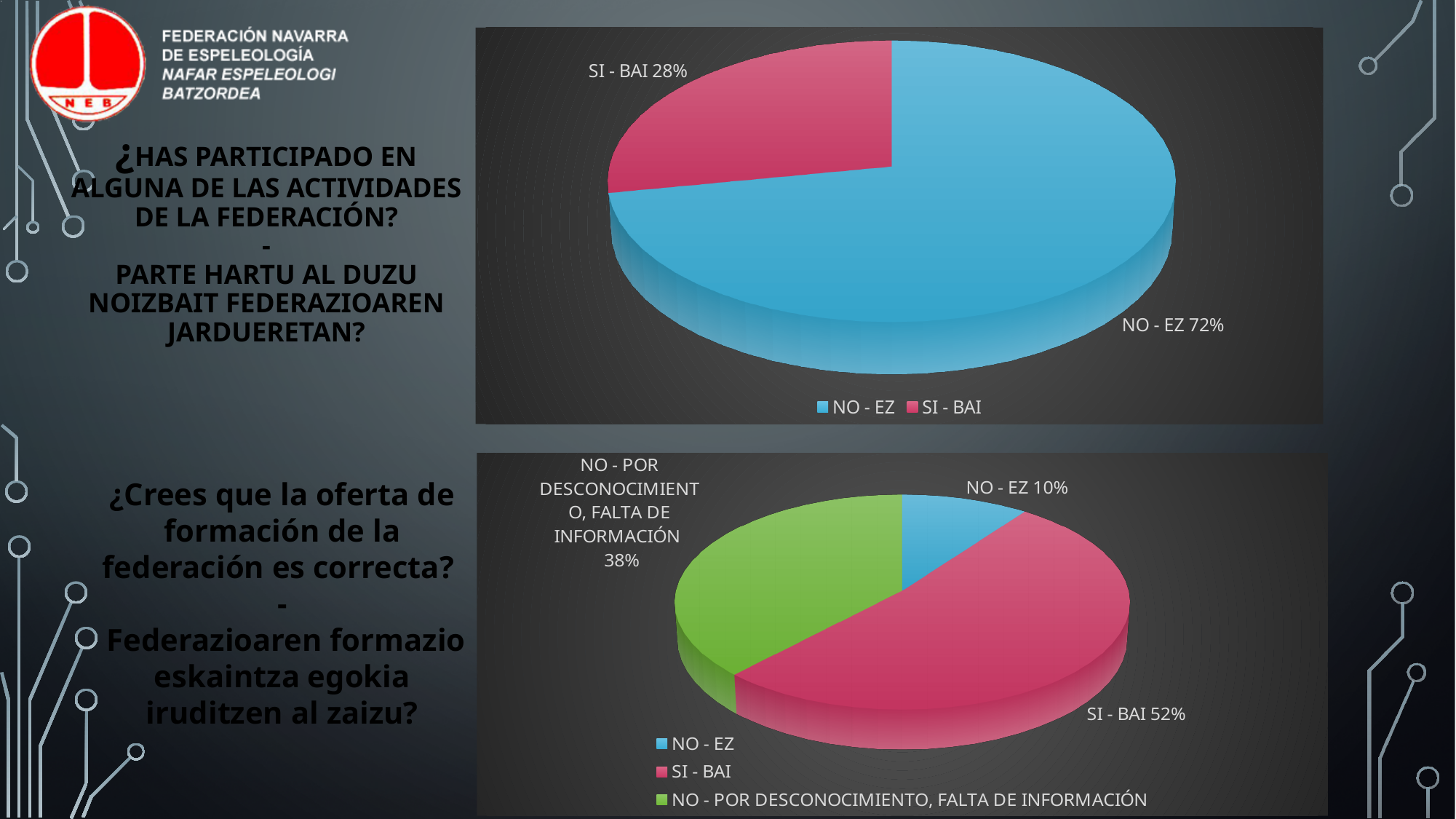
What type of chart is the top chart on the slide? Pie chart How many entries does the legend of the bottom pie chart list? 3 In the top pie chart, what is the difference in percentage points between NO - EZ and SI - BAI? 44 In the bottom pie chart, which is larger: SI - BAI or NO - POR DESCONOCIMIENTO, FALTA DE INFORMACIÓN? SI - BAI In the bottom pie chart, what percentage is labelled for NO - EZ? 10% In the top pie chart, what percentage is labelled for SI - BAI? 28% In the bottom pie chart, what percentage is labelled for NO - POR DESCONOCIMIENTO, FALTA DE INFORMACIÓN? 38% In the top pie chart, which slice is the largest? NO - EZ In the bottom pie chart, which slice is the smallest? NO - EZ In the top pie chart, what percentage is labelled for NO - EZ? 72% How many slices does the top pie chart have? 2 In the bottom pie chart, what percentage is labelled for SI - BAI? 52%